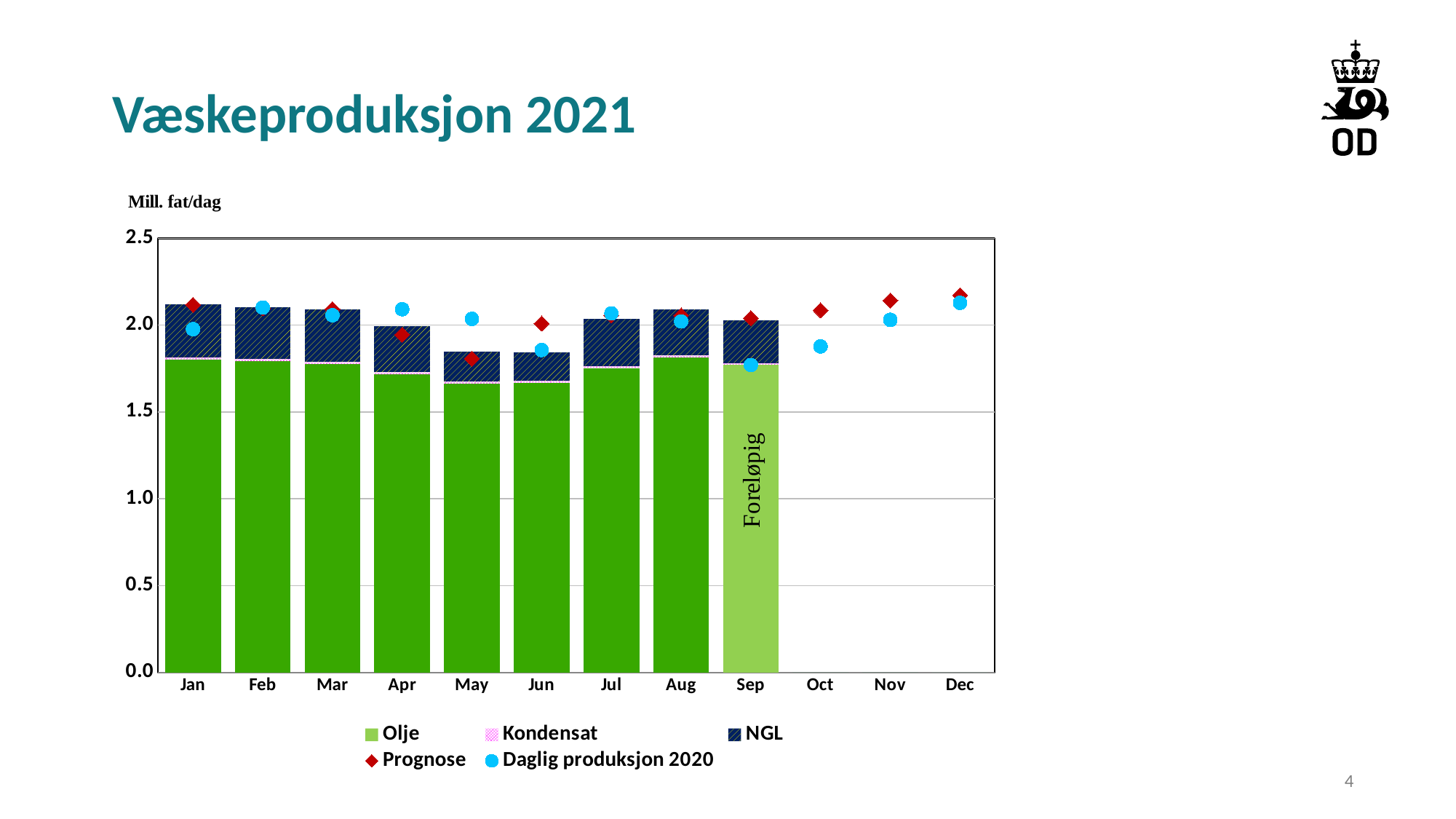
How many series does the legend list? 5 What label is written on the Sep bar? Foreløpig Which is larger, the total stacked bar for Jan or for May? Jan Do the Prognose values rise or fall from Oct to Dec? rise Is the total stacked bar for Jan greater or less than 2.0? greater What unit is given on the vertical axis? Mill. fat/dag Is the total stacked bar for May greater or less than 2.0? less For how many months are stacked bars plotted? 9 Is the Daglig produksjon 2020 value for Oct greater or less than 2.0? less How many months are shown on the x axis? 12 What kind of chart is shown on the slide? Stacked bar chart with overlaid point markers